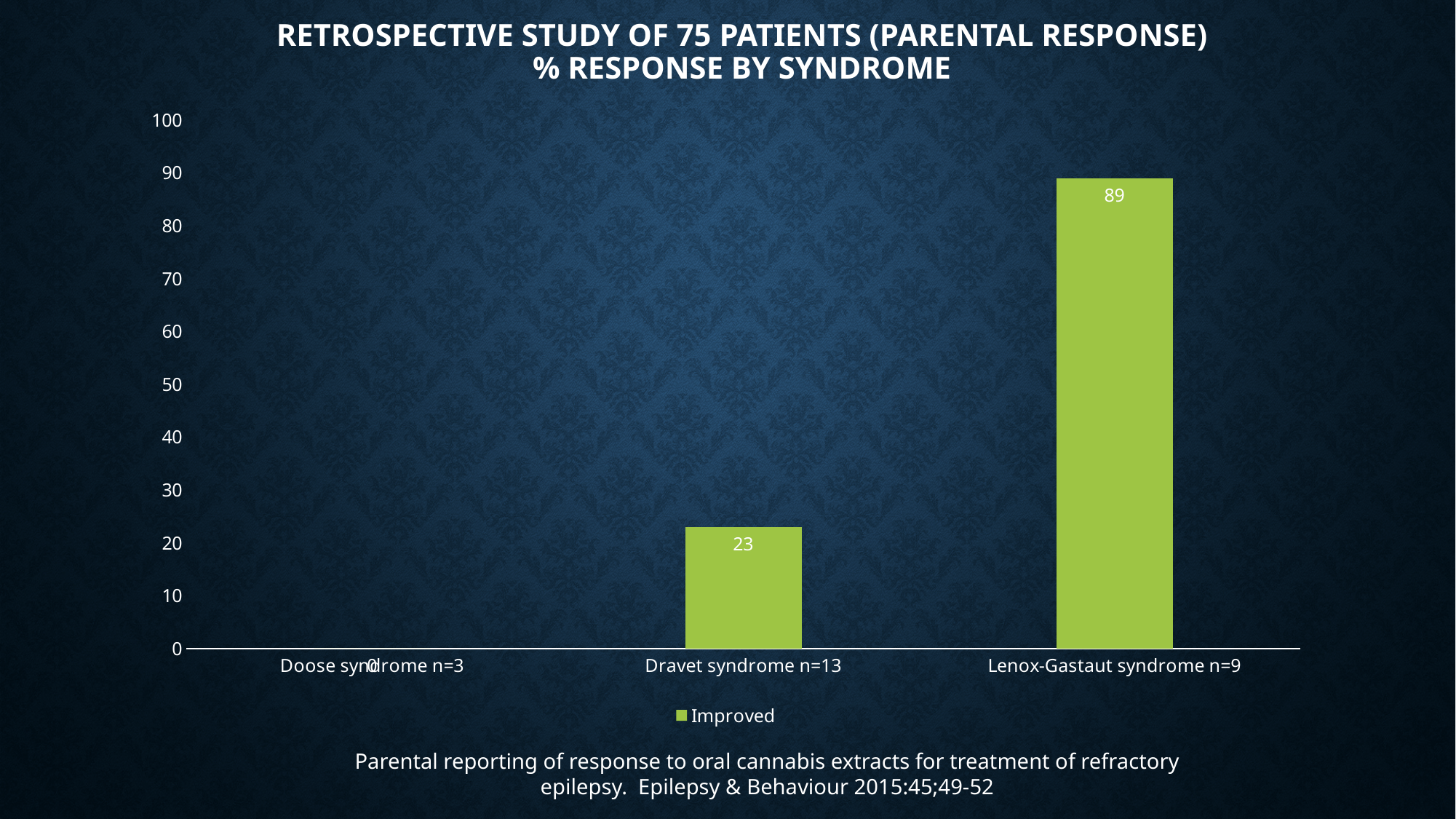
Which is larger, the value for Dravet syndrome n=13 or the value for Lenox-Gastaut syndrome n=9? Lenox-Gastaut syndrome n=9 What is the value for Dravet syndrome n=13? 23 Which syndrome has the highest value? Lenox-Gastaut syndrome n=9 How many series does the legend list? 1 What is the value for Doose syndrome n=3? 0 What kind of chart is shown on the slide? bar chart How many syndrome categories are shown on the x axis? 3 What is the value for Lenox-Gastaut syndrome n=9? 89 Which syndrome has the lowest value? Doose syndrome n=3 What is the name of the series shown in the legend? Improved What is the difference between the values for Lenox-Gastaut syndrome n=9 and Dravet syndrome n=13? 66 Is the value for Dravet syndrome n=13 greater or less than 30? less